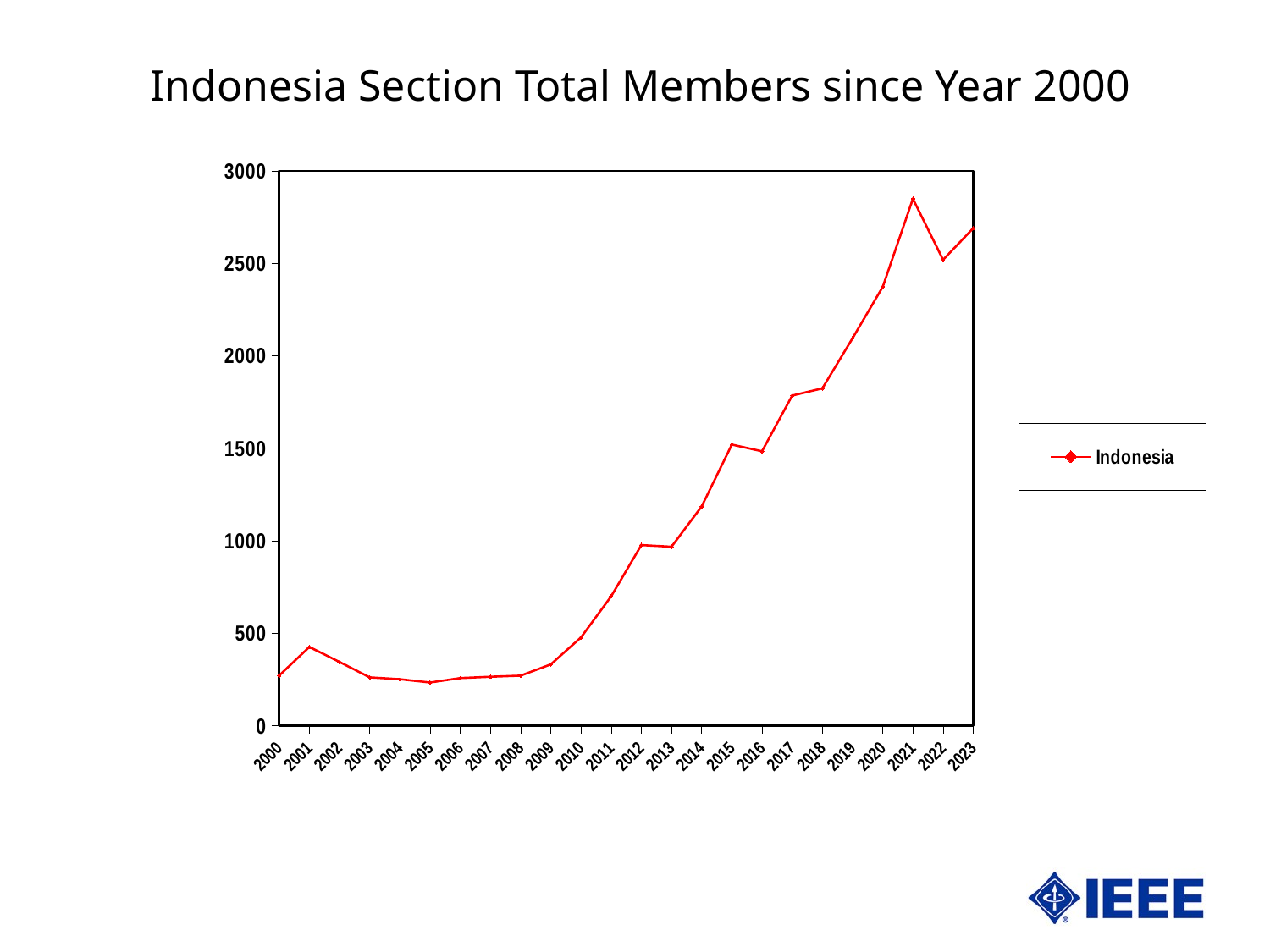
Is the value for 2020 greater or less than 2500? less How many series does the legend list? 1 Which year has the larger value, 2021 or 2023? 2021 Is the value for 2021 greater or less than 2500? greater What is the title of the chart? Indonesia Section Total Members since Year 2000 How many years are plotted along the x axis? 24 Is the value for 2000 greater or less than 500? less Do the values generally rise or fall from 2009 to 2021? rise Which year has the larger value, 2000 or 2001? 2001 What kind of chart is shown on the slide? line chart In which year is the number of members highest? 2021